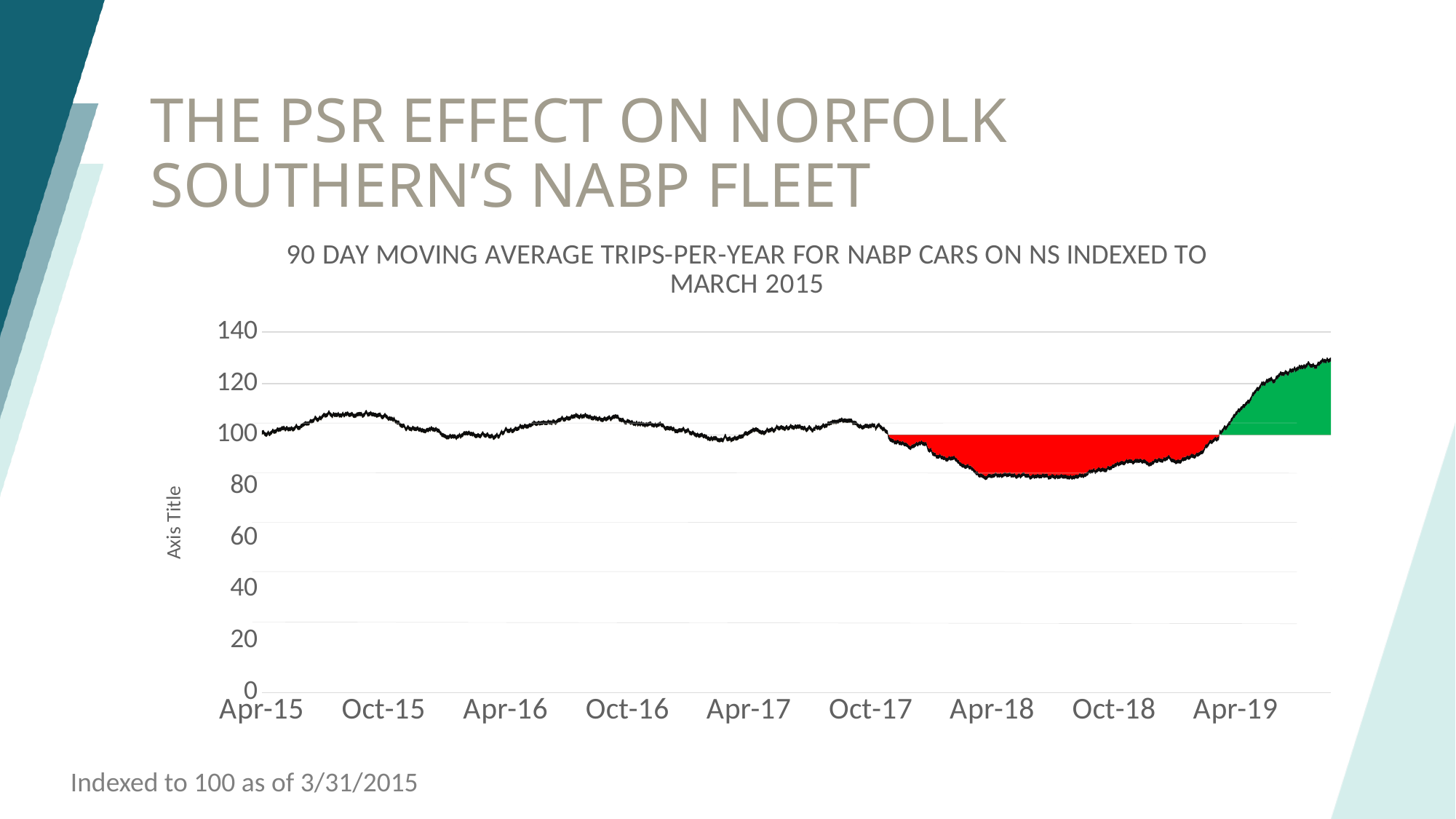
Is the value at Oct-15 greater or less than 100? greater Is the value at the final point of the line (right end) greater or less than 120? greater Is the value at Apr-18 greater or less than 60? greater Does the line rise or fall between Oct-17 and Apr-18? fall Which of the two values is larger: the value at Oct-15 or the value at Apr-18? Oct-15 What is the title of the chart? 90 DAY MOVING AVERAGE TRIPS-PER-YEAR FOR NABP CARS ON NS INDEXED TO MARCH 2015 Does the line rise or fall between Apr-18 and Apr-19? rise How many date labels are shown on the horizontal axis? 9 What is the highest tick value shown on the vertical axis? 140 What kind of chart is shown on the slide? line chart